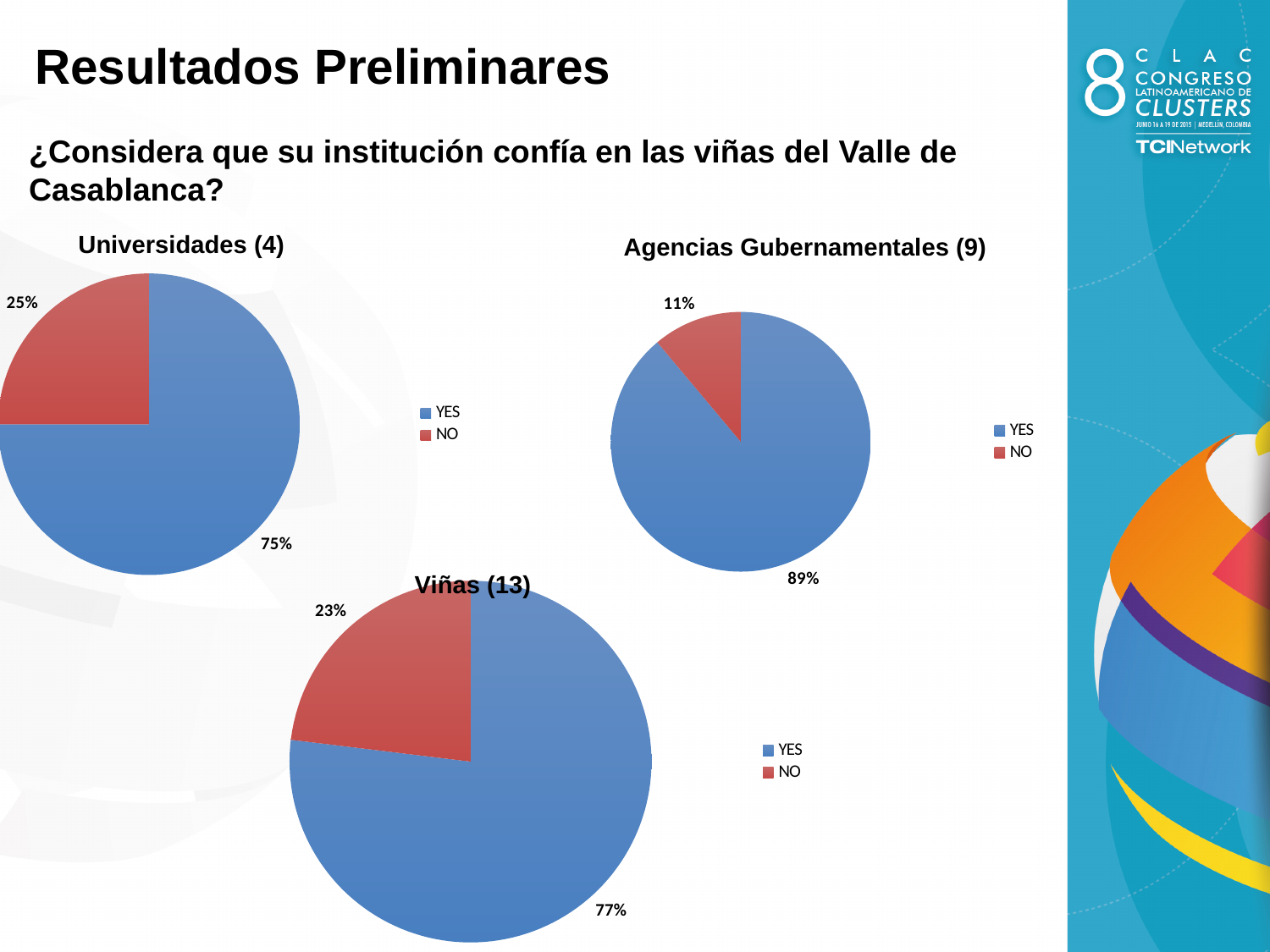
In the 'Viñas (13)' pie chart, what percentage is labelled for YES? 77% In the 'Agencias Gubernamentales (9)' pie chart, what percentage is labelled for YES? 89% What kind of chart is 'Universidades (4)'? Pie chart In the 'Universidades (4)' pie chart, what colour represents NO? Red In the 'Universidades (4)' pie chart, what percentage is labelled for YES? 75% In the 'Universidades (4)' pie chart, what percentage is labelled for NO? 25% How many slices does the 'Viñas (13)' pie chart have? 2 In the 'Viñas (13)' pie chart, which slice is larger, YES or NO? YES How many entries does the legend of the 'Agencias Gubernamentales (9)' chart list? 2 In the 'Viñas (13)' pie chart, what percentage is labelled for NO? 23% In the 'Agencias Gubernamentales (9)' pie chart, what percentage is labelled for NO? 11% In the 'Agencias Gubernamentales (9)' pie chart, what is the difference in percentage points between the YES and NO slices? 78